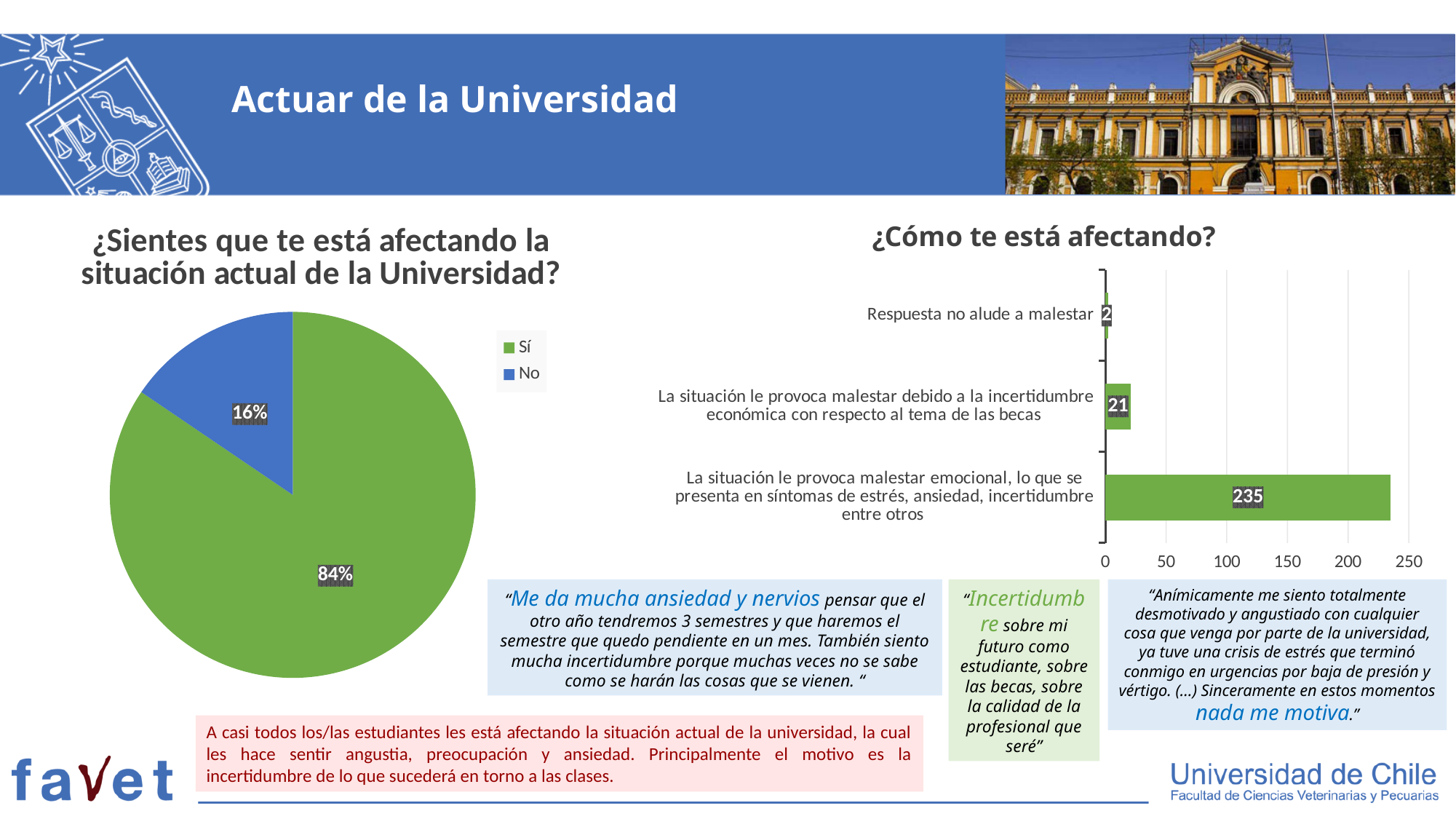
In the pie chart '¿Sientes que te está afectando la situación actual de la Universidad?', what is the difference in percentage points between 'Sí' and 'No'? 68 In the bar chart '¿Cómo te está afectando?', how many categories are shown? 3 In the bar chart '¿Cómo te está afectando?', which category has the lowest value? Respuesta no alude a malestar In the bar chart '¿Cómo te está afectando?', what is the difference between the value for emotional distress (235) and the value for economic uncertainty about scholarships (21)? 214 In the bar chart '¿Cómo te está afectando?', what is the value for 'Respuesta no alude a malestar'? 2 In the pie chart '¿Sientes que te está afectando la situación actual de la Universidad?', what percentage answered 'No'? 16% In the bar chart '¿Cómo te está afectando?', what is the value for 'La situación le provoca malestar debido a la incertidumbre económica con respecto al tema de las becas'? 21 In the pie chart '¿Sientes que te está afectando la situación actual de la Universidad?', which answer has the larger share? Sí What kind of chart is '¿Cómo te está afectando?'? Bar chart In the bar chart '¿Cómo te está afectando?', what is the value for 'La situación le provoca malestar emocional, lo que se presenta en síntomas de estrés, ansiedad, incertidumbre entre otros'? 235 In the pie chart '¿Sientes que te está afectando la situación actual de la Universidad?', what percentage answered 'Sí'? 84% In the pie chart '¿Sientes que te está afectando la situación actual de la Universidad?', how many slices are there? 2